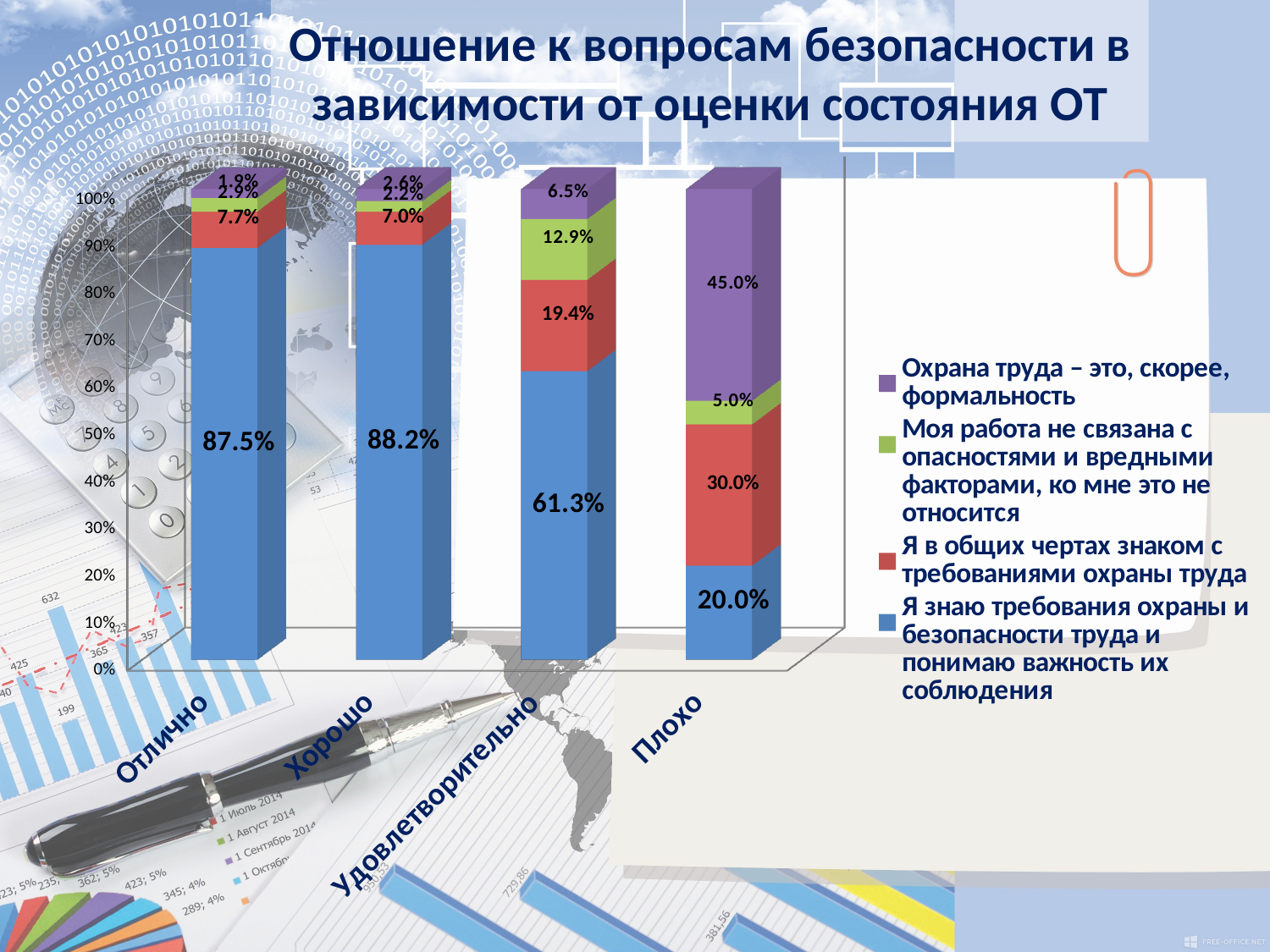
What is the value of the purple segment (Охрана труда – это, скорее, формальность) for the category Удовлетворительно? 6.5% How many categories are shown on the x axis of the chart? 4 Which category has the lowest value for the blue segment (Я знаю требования охраны и безопасности труда и понимаю важность их соблюдения)? Плохо What is the value of the green segment (Моя работа не связана с опасностями и вредными факторами, ко мне это не относится) for the category Удовлетворительно? 12.9% How many series does the legend list? 4 Which is larger: the red segment (Я в общих чертах знаком с требованиями охраны труда) for Удовлетворительно or for Плохо? Плохо What kind of chart is shown on the slide? Stacked bar chart What is the value of the blue segment (Я знаю требования охраны и безопасности труда и понимаю важность их соблюдения) for the category Плохо? 20.0% What is the value of the red segment (Я в общих чертах знаком с требованиями охраны труда) for the category Плохо? 30.0% Which category has the highest value for the blue segment (Я знаю требования охраны и безопасности труда и понимаю важность их соблюдения)? Хорошо What is the difference between the purple segment (Охрана труда – это, скорее, формальность) for Плохо and for Удовлетворительно? 38.5% What is the value of the blue segment (Я знаю требования охраны и безопасности труда и понимаю важность их соблюдения) for the category Отлично? 87.5%